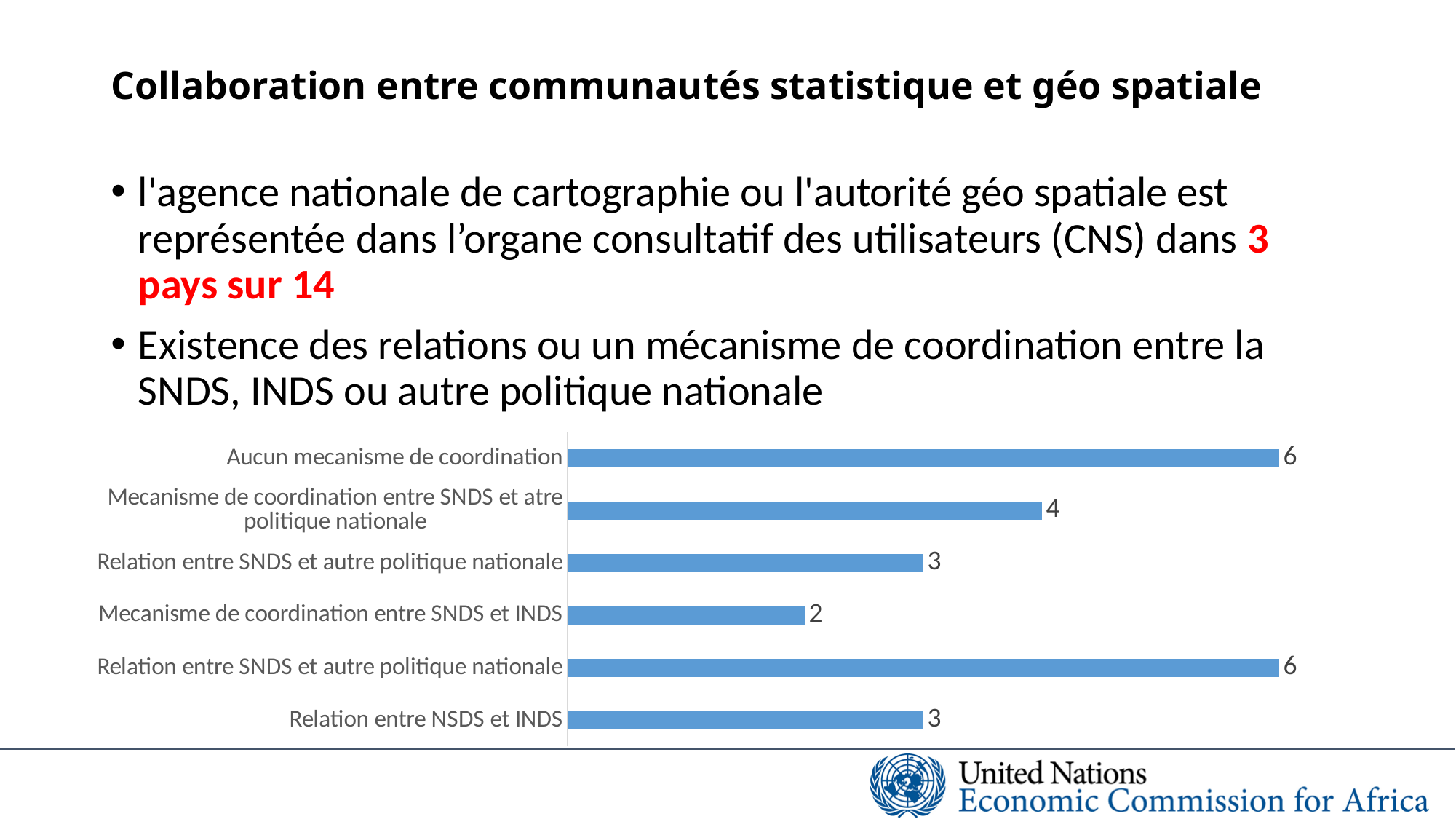
Which category has the lowest value in the chart? Mecanisme de coordination entre SNDS et INDS Which is larger: the value for "Aucun mecanisme de coordination" or the value for "Mecanisme de coordination entre SNDS et atre politique nationale"? Aucun mecanisme de coordination What is the value for "Relation entre NSDS et INDS"? 3 What colour are the bars in the chart? blue How many categories are plotted in the bar chart? 6 What is the difference between the value for "Aucun mecanisme de coordination" and the value for "Mecanisme de coordination entre SNDS et INDS"? 4 What is the value for "Mecanisme de coordination entre SNDS et atre politique nationale"? 4 What is the difference between the value for "Mecanisme de coordination entre SNDS et atre politique nationale" and the value for "Relation entre NSDS et INDS"? 1 What is the value for "Aucun mecanisme de coordination"? 6 Which is larger: the value for "Relation entre NSDS et INDS" or the value for "Mecanisme de coordination entre SNDS et INDS"? Relation entre NSDS et INDS What is the value for "Mecanisme de coordination entre SNDS et INDS"? 2 What type of chart is shown on the slide? bar chart